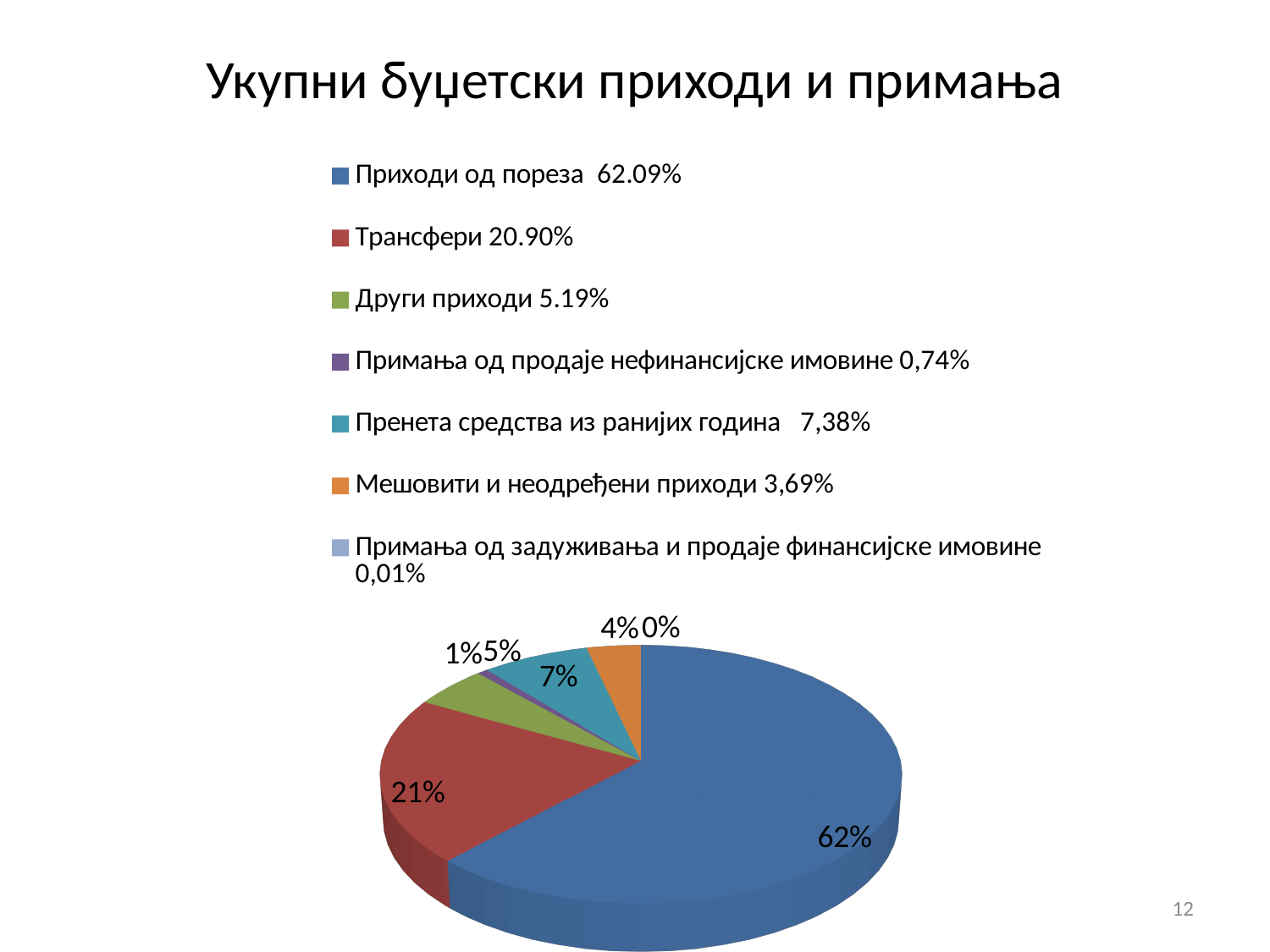
How many categories does the legend of the pie chart list? 7 What percentage label is shown on the pie slice for Трансфери? 21% What share does the legend give for Други приходи? 5.19% What is the title of the chart on the slide? Укупни буџетски приходи и примања Which category has the largest share of the pie? Приходи од пореза What percentage label is shown on the pie slice for Мешовити и неодређени приходи? 4% Which category has the smallest share of the pie? Примања од задуживања и продаје финансијске имовине What percentage label is shown on the pie slice for Приходи од пореза? 62% What percentage label is shown on the pie slice for Пренета средства из ранијих година? 7% Which has a larger share of the pie, Други приходи or Пренета средства из ранијих година? Пренета средства из ранијих година What kind of chart is shown on the slide? pie chart What is the difference between the pie slice labels for Приходи од пореза and Трансфери? 41%